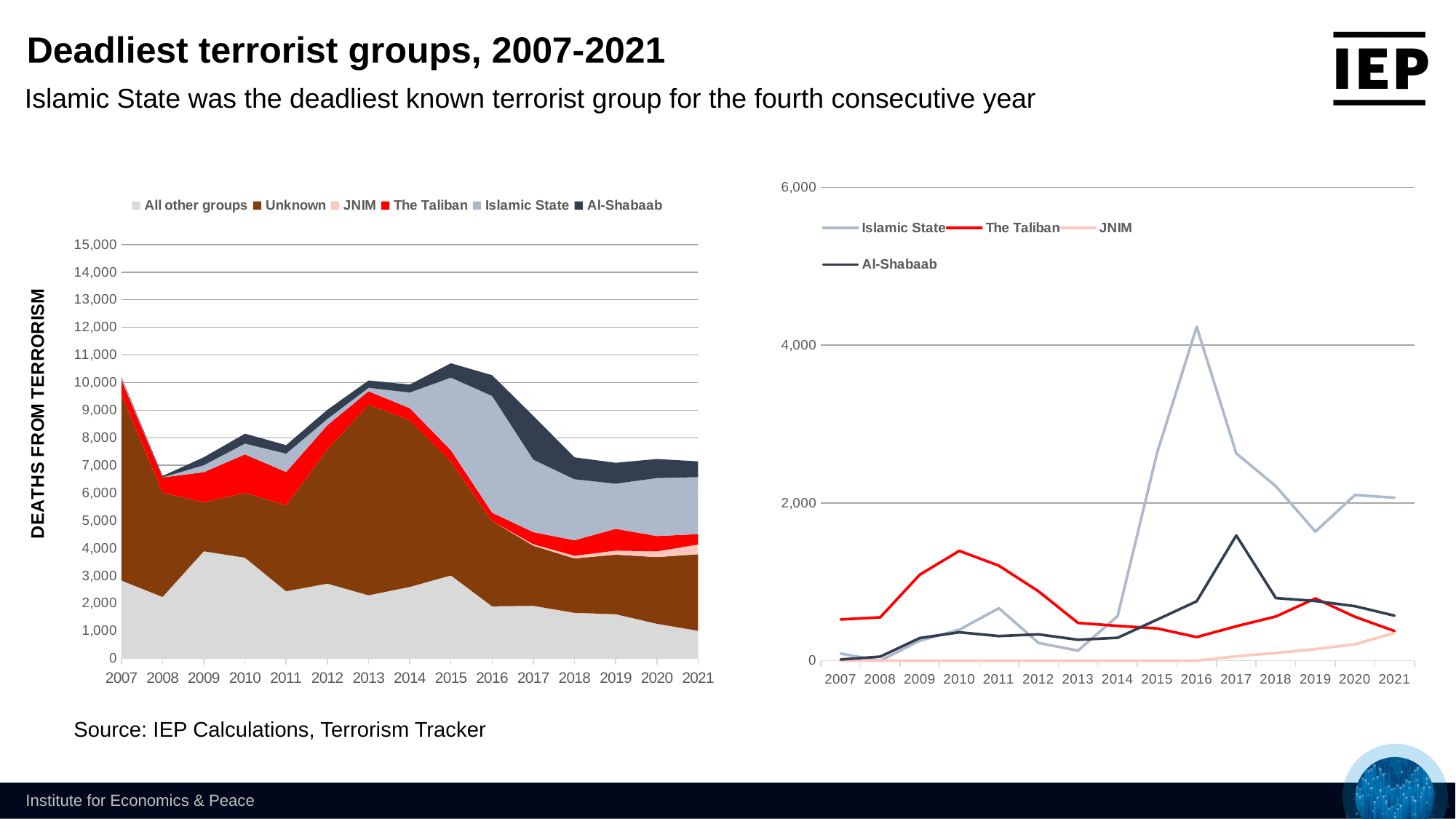
In the right chart, is the value for Islamic State in 2016 greater or less than 4,000? greater In the right chart, is the value for The Taliban in 2010 greater or less than 2,000? less What is the y-axis label of the left chart? DEATHS FROM TERRORISM In the right chart, in which year does the Islamic State line reach its highest value? 2016 In the right chart, does the Islamic State line rise or fall from 2016 to 2019? fall In the right chart, which series reaches the highest value of any series? Islamic State How many series does the legend of the right chart list? 4 How many years are shown on the x axis of the right chart? 15 How many series does the legend of the left chart list? 6 In the left chart, is the total stacked value in 2015 greater or less than 10,000? greater In the right chart, which is larger in 2010, The Taliban or Al-Shabaab? The Taliban What kind of chart is the chart on the right of the slide? line chart